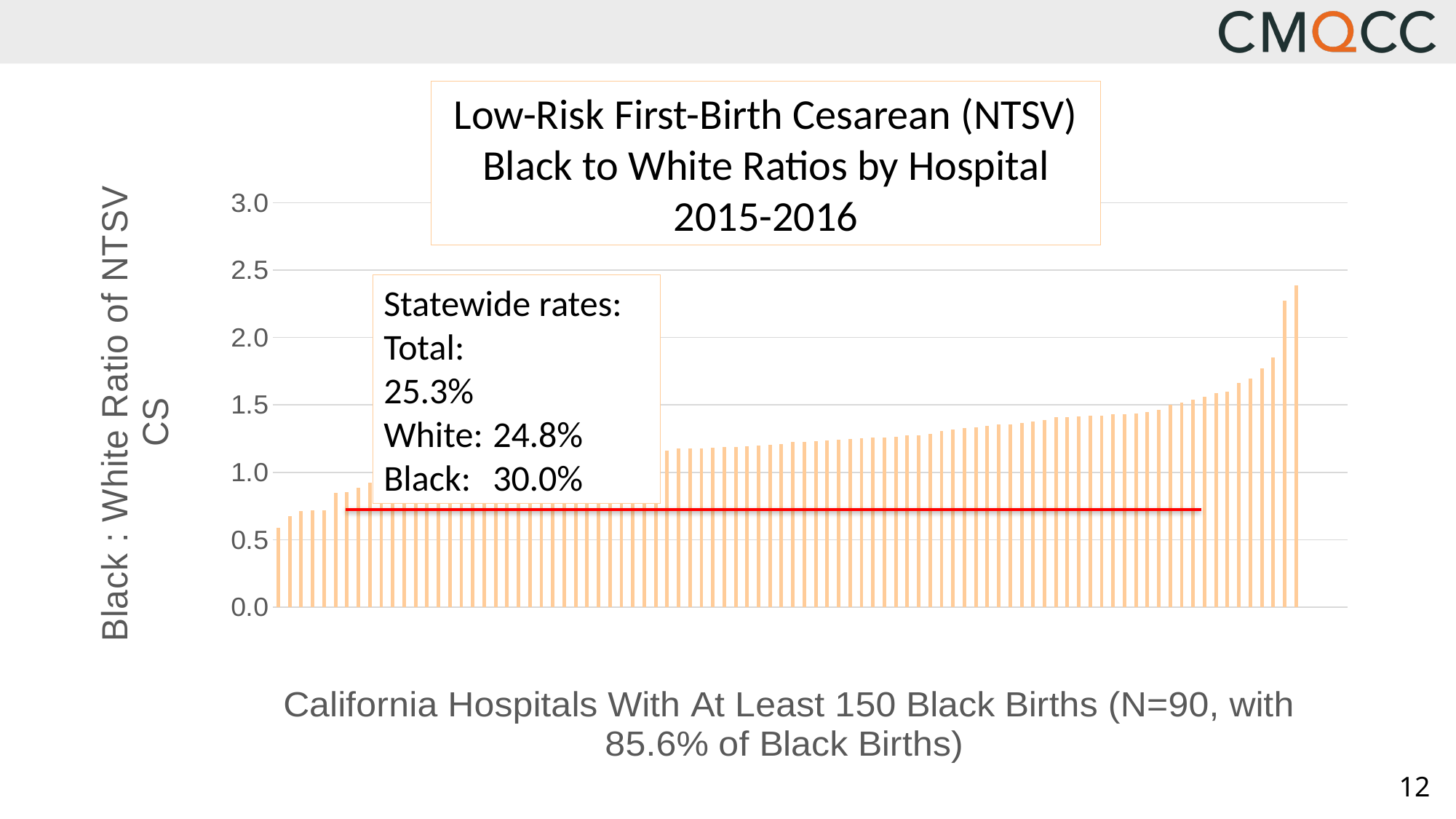
Is the value of the tallest bar greater or less than 2.0? greater What kind of chart is shown on the slide? Bar chart What is the highest value shown on the y axis? 3.0 How many hospitals are represented in the chart, according to the x-axis label? 90 What is the title of the chart? Low-Risk First-Birth Cesarean (NTSV) Black to White Ratios by Hospital 2015-2016 What is the statewide total NTSV cesarean rate shown in the annotation box? 25.3% Is the value of the leftmost bar greater or less than 0.5? greater What is the statewide NTSV cesarean rate for White patients shown in the annotation box? 24.8% Do the bar values rise or fall from left to right along the x axis? Rise Is the value of the shortest bar greater or less than 1.0? less Which statewide rate is higher in the annotation box, White or Black? Black What is the statewide NTSV cesarean rate for Black patients shown in the annotation box? 30.0%